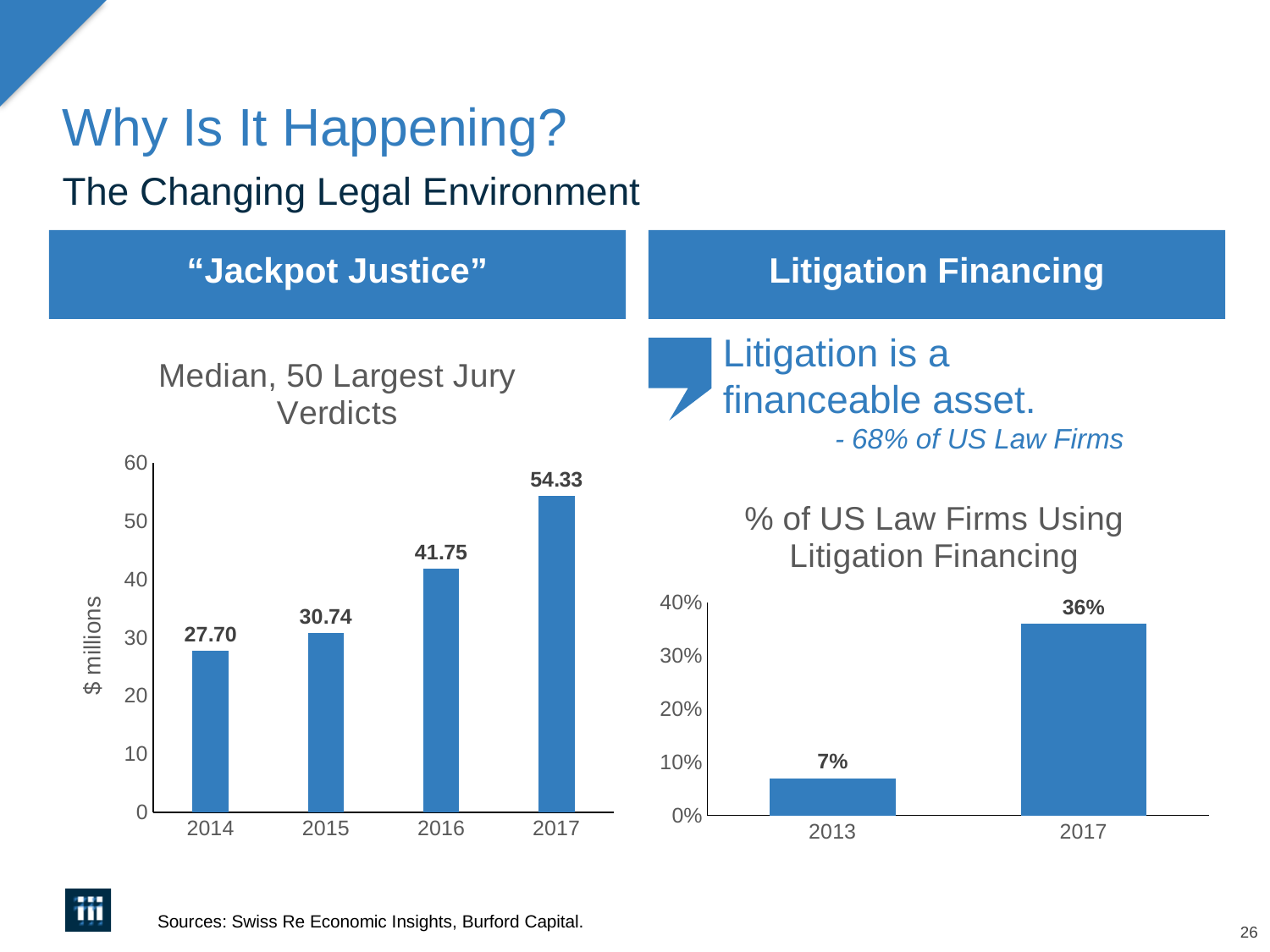
In the 'Median, 50 Largest Jury Verdicts' chart, which year has the highest value? 2017 In the '% of US Law Firms Using Litigation Financing' chart, what is the value for 2013? 7% In the '% of US Law Firms Using Litigation Financing' chart, what is the value for 2017? 36% What is the y-axis label of the 'Median, 50 Largest Jury Verdicts' chart? $ millions In the '% of US Law Firms Using Litigation Financing' chart, what is the difference between the 2017 and 2013 values? 29% In the 'Median, 50 Largest Jury Verdicts' chart, what is the difference between the 2017 and 2016 values? 12.58 In the 'Median, 50 Largest Jury Verdicts' chart, what is the value for 2016? 41.75 What kind of chart is the '% of US Law Firms Using Litigation Financing' chart? bar chart In the 'Median, 50 Largest Jury Verdicts' chart, which year has the lowest value? 2014 How many years are shown in the 'Median, 50 Largest Jury Verdicts' chart? 4 In the 'Median, 50 Largest Jury Verdicts' chart, do the values rise or fall from 2014 to 2017? rise In the 'Median, 50 Largest Jury Verdicts' chart, what is the value for 2014? 27.70